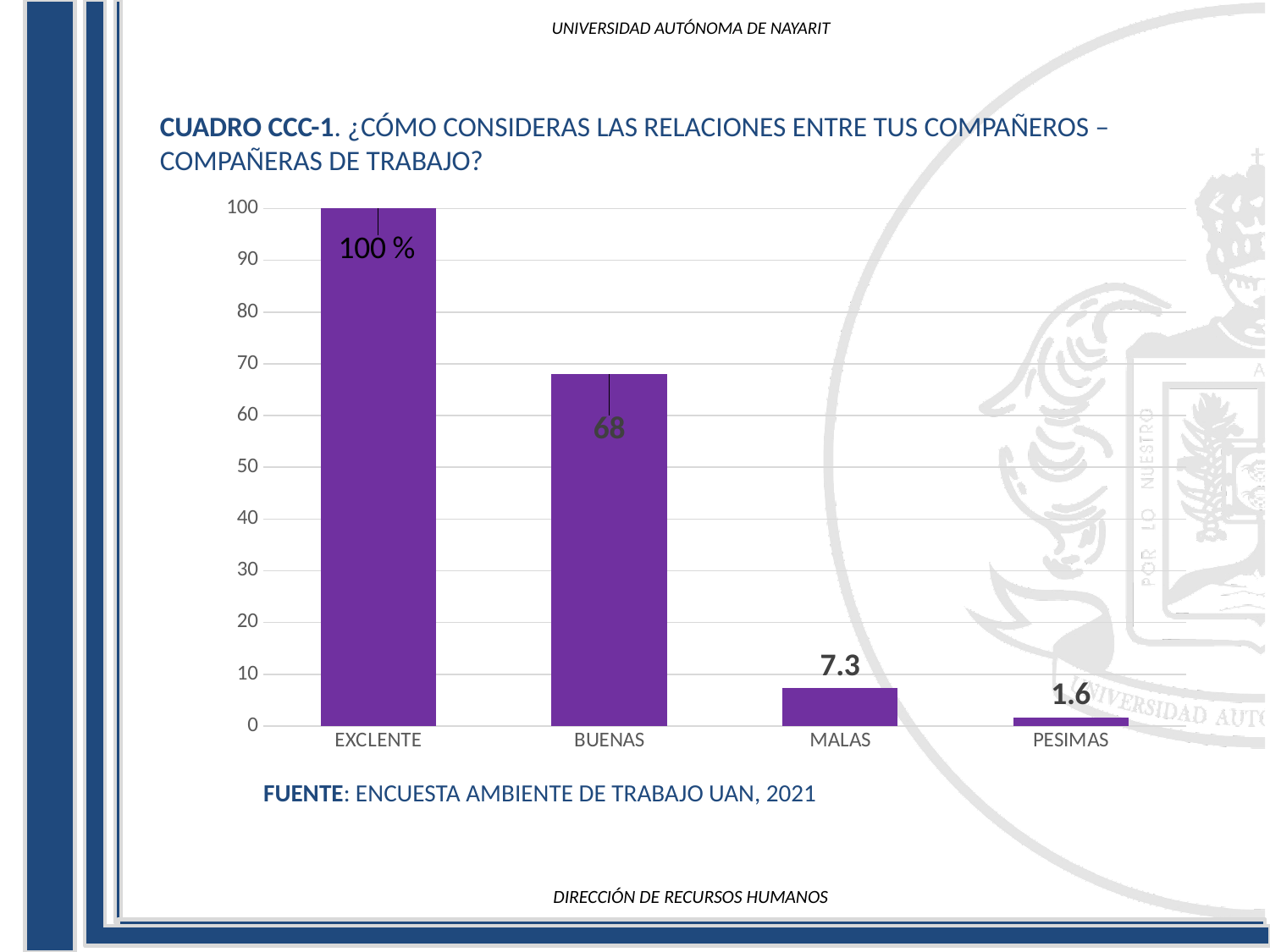
What value is shown for BUENAS? 68 Do the values rise or fall from left to right along the x axis? fall What value is shown for PESIMAS? 1.6 What data label is shown on the EXCLENTE bar? 100 % Which category has the lowest value? PESIMAS Is the value for BUENAS greater or less than 60? greater What kind of chart is shown on the slide? bar chart What is the difference between the values for MALAS and PESIMAS? 5.7 What value is shown for MALAS? 7.3 Which is larger, the value for BUENAS or the value for MALAS? BUENAS How many categories are shown on the x axis? 4 Which category has the highest value? EXCLENTE